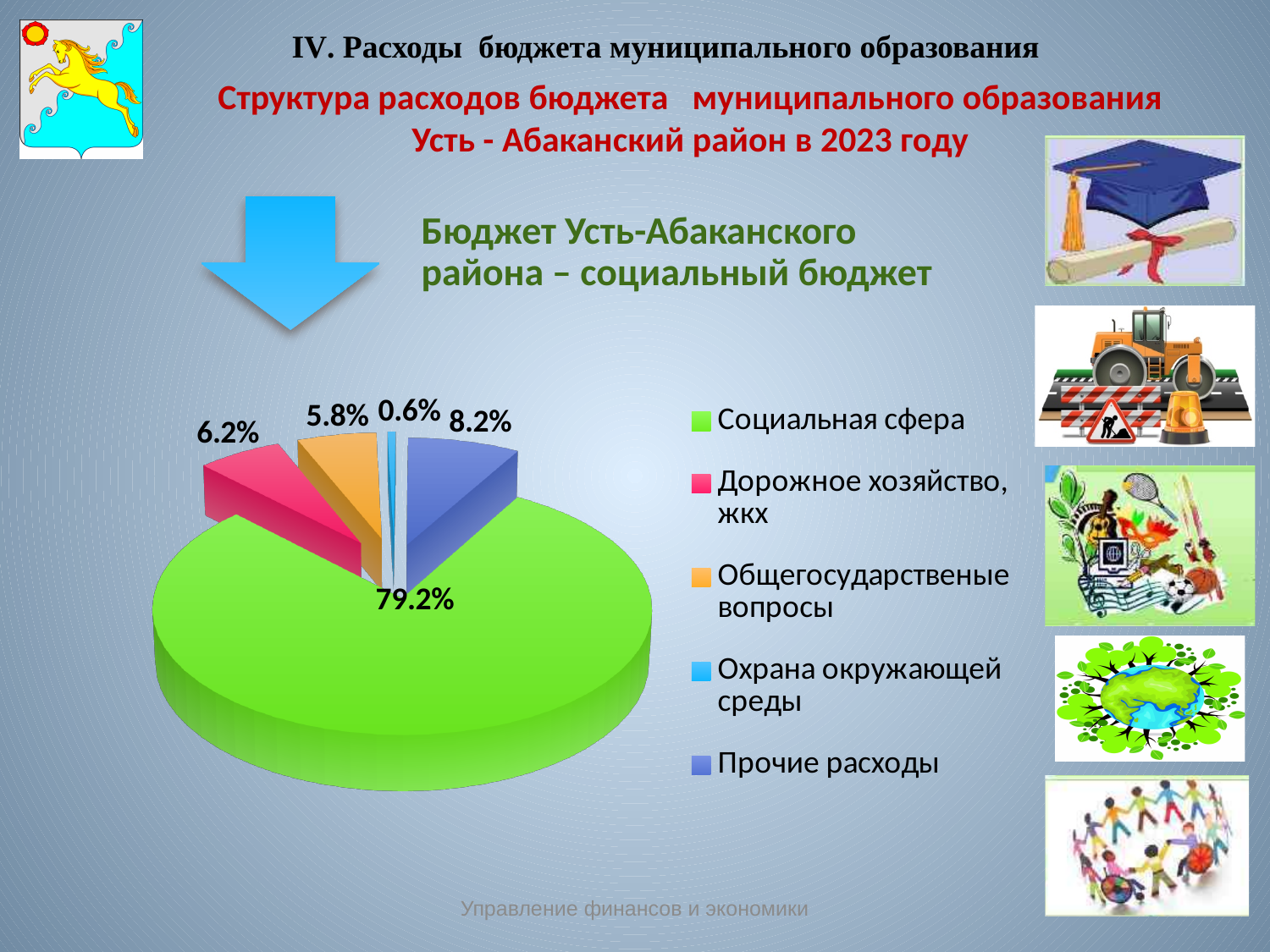
How many categories does the legend list? 5 What kind of chart is shown on the slide? pie chart What colour is the slice for Социальная сфера? green What is the value shown for Общегосударственые вопросы? 5.8% Which category has the largest share of the pie? Социальная сфера What is the value shown for Охрана окружающей среды? 0.6% What share of the pie does Социальная сфера have? 79.2% What is the value shown for Прочие расходы? 8.2% What is the value shown for Дорожное хозяйство, жкх? 6.2% What is the difference between the shares of Прочие расходы and Дорожное хозяйство, жкх? 2.0% Which category has the smallest share of the pie? Охрана окружающей среды Which is larger, the share of Дорожное хозяйство, жкх or the share of Общегосударственые вопросы? Дорожное хозяйство, жкх